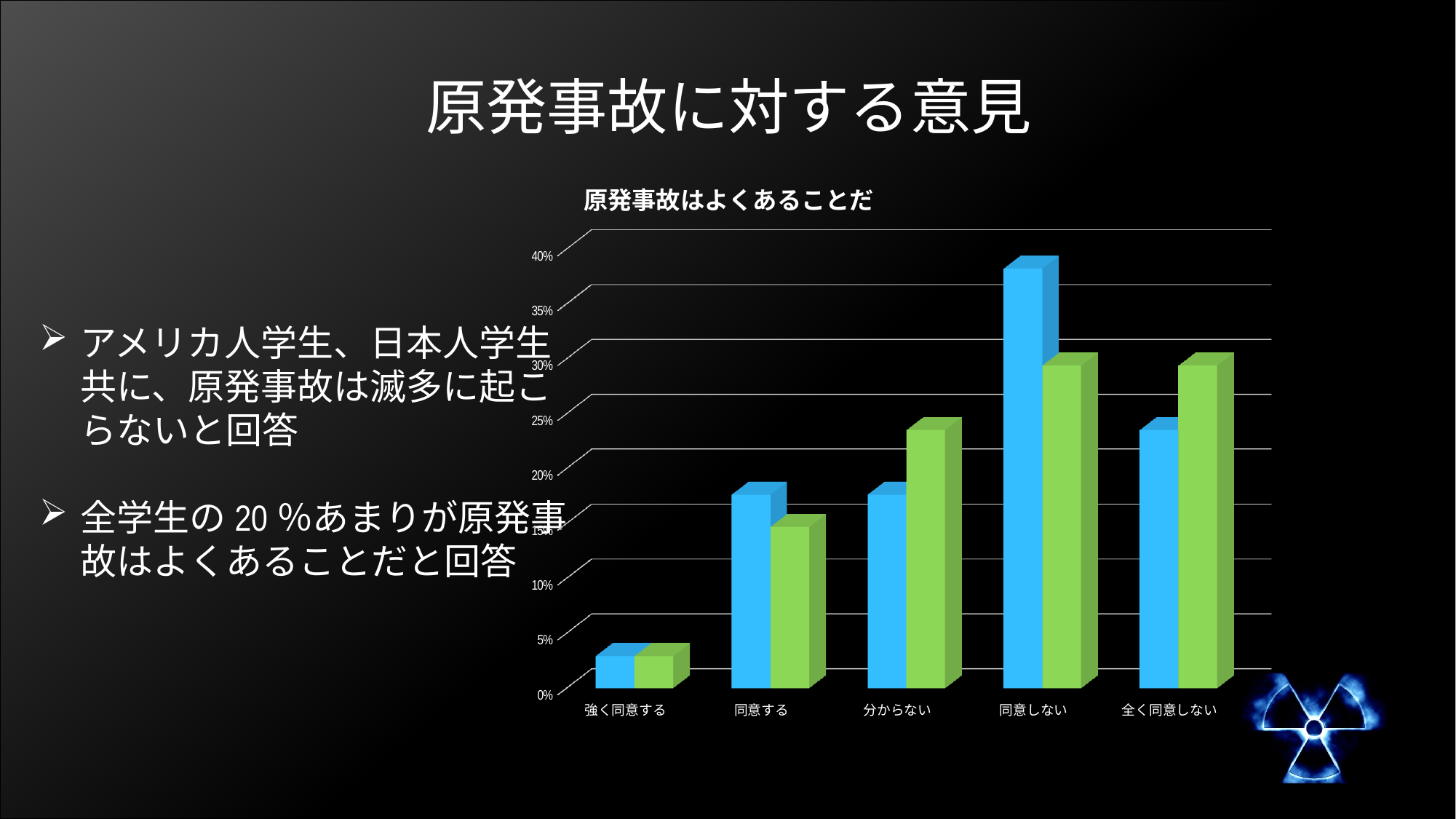
What kind of chart is shown on the slide? bar chart For 同意しない, which bar is taller, the blue one or the green one? blue What two colours are used for the bars in the chart? blue and green Is the green bar for 分からない greater or less than 20%? greater Which category has the lowest green bar? 強く同意する Which category has the lowest blue bar? 強く同意する Which category has the highest blue bar? 同意しない Is the blue bar for 同意しない greater or less than 35%? greater For 分からない, which bar is taller, the blue one or the green one? green Is the green bar for 同意する greater or less than 20%? less How many categories are shown on the x axis of the chart? 5 What is the title of the chart? 原発事故はよくあることだ